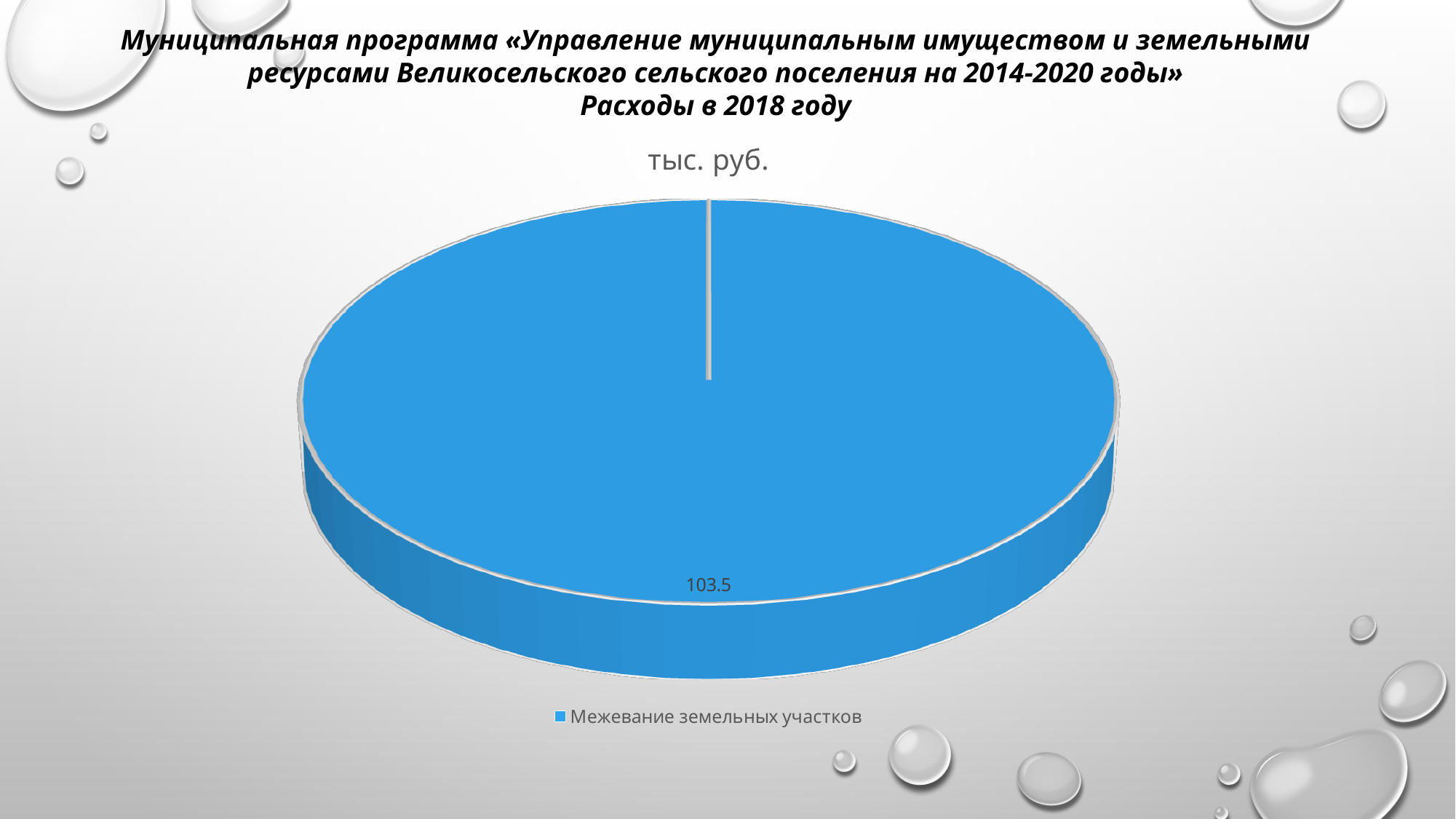
Is the value for Межевание земельных участков greater or less than 100? greater What share of the pie does the Межевание земельных участков slice represent? 100% What is the value shown for Межевание земельных участков? 103.5 How many slices does the pie chart have? 1 What kind of chart is shown on the slide? pie chart How many entries does the legend list? 1 What category is listed in the legend? Межевание земельных участков What is the title of the chart? тыс. руб.